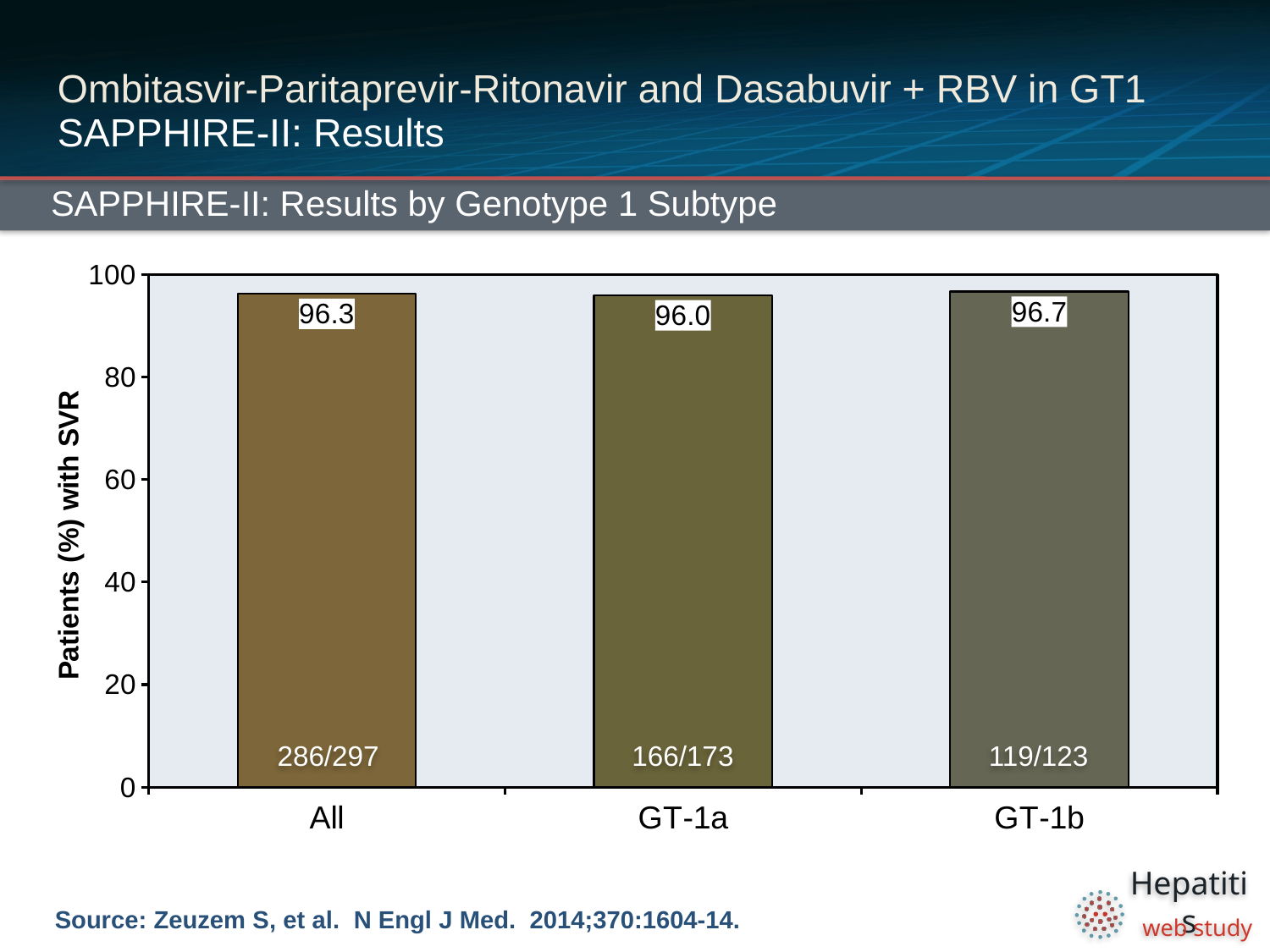
What is the SVR rate for the All group? 96.3 What is the label of the y axis? Patients (%) with SVR Which category has the lowest SVR rate? GT-1a Is the SVR rate for GT-1a greater or less than 80? greater What is the SVR rate for GT-1b? 96.7 What is the difference in SVR rate between GT-1b and GT-1a? 0.7 What fraction of patients is shown inside the GT-1a bar? 166/173 Which subtype has the highest SVR rate? GT-1b How many categories are shown on the x axis? 3 What fraction of patients is shown inside the All bar? 286/297 What type of chart is shown on the slide? Bar chart What is the SVR rate for GT-1a? 96.0